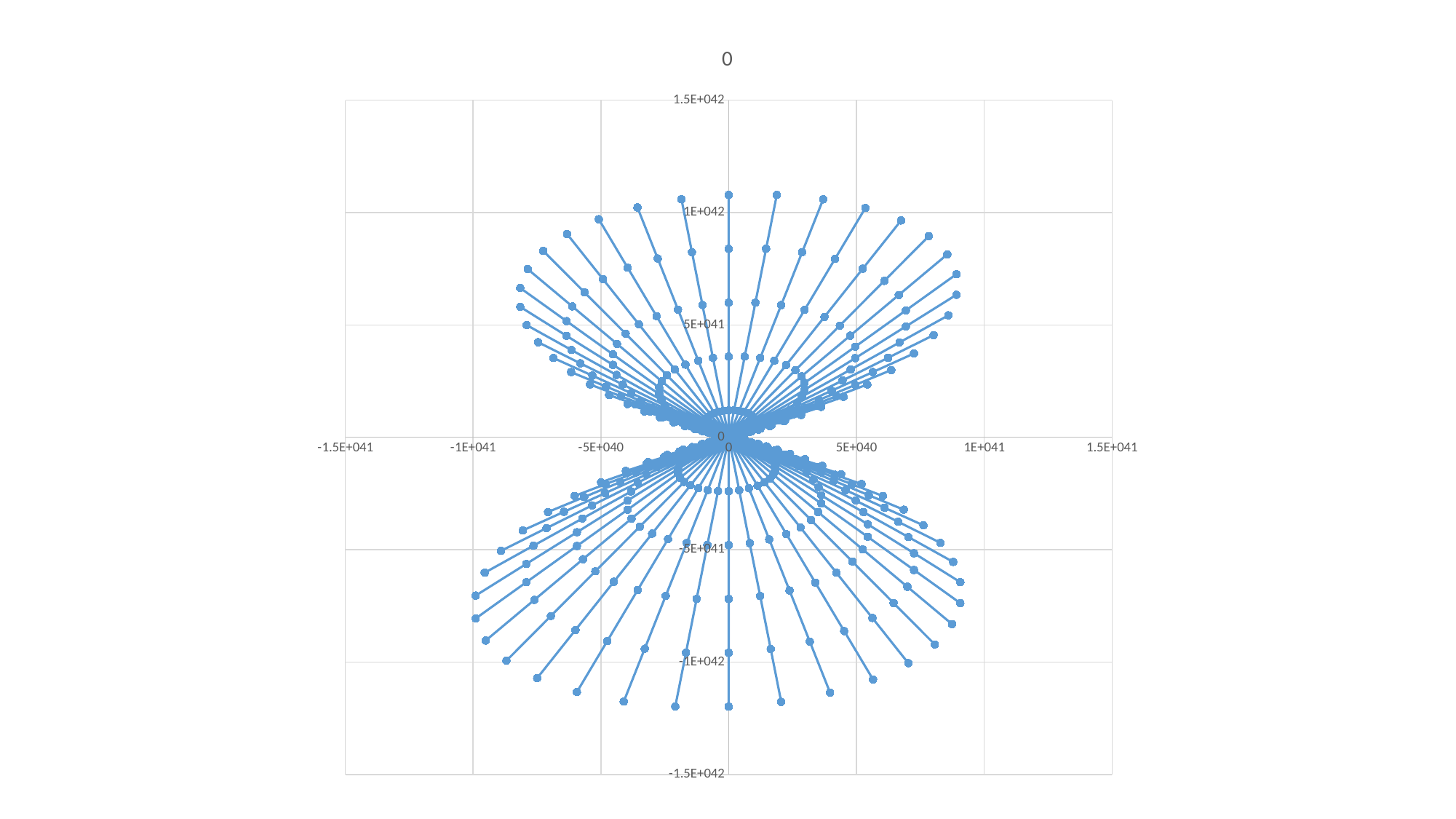
Is the lowest plotted point on the chart greater or less than -1E+042 on the vertical axis? less What is the highest value shown on the vertical axis of the chart? 1.5E+042 Is the highest plotted point on the chart greater or less than 1E+042 on the vertical axis? greater Does any plotted point on the chart reach above 1.5E+042 on the vertical axis? No What is the lowest value labelled on the horizontal axis of the chart? -1.5E+041 What kind of chart is shown on the slide? Scatter chart with lines and markers What is the title of the chart? 0